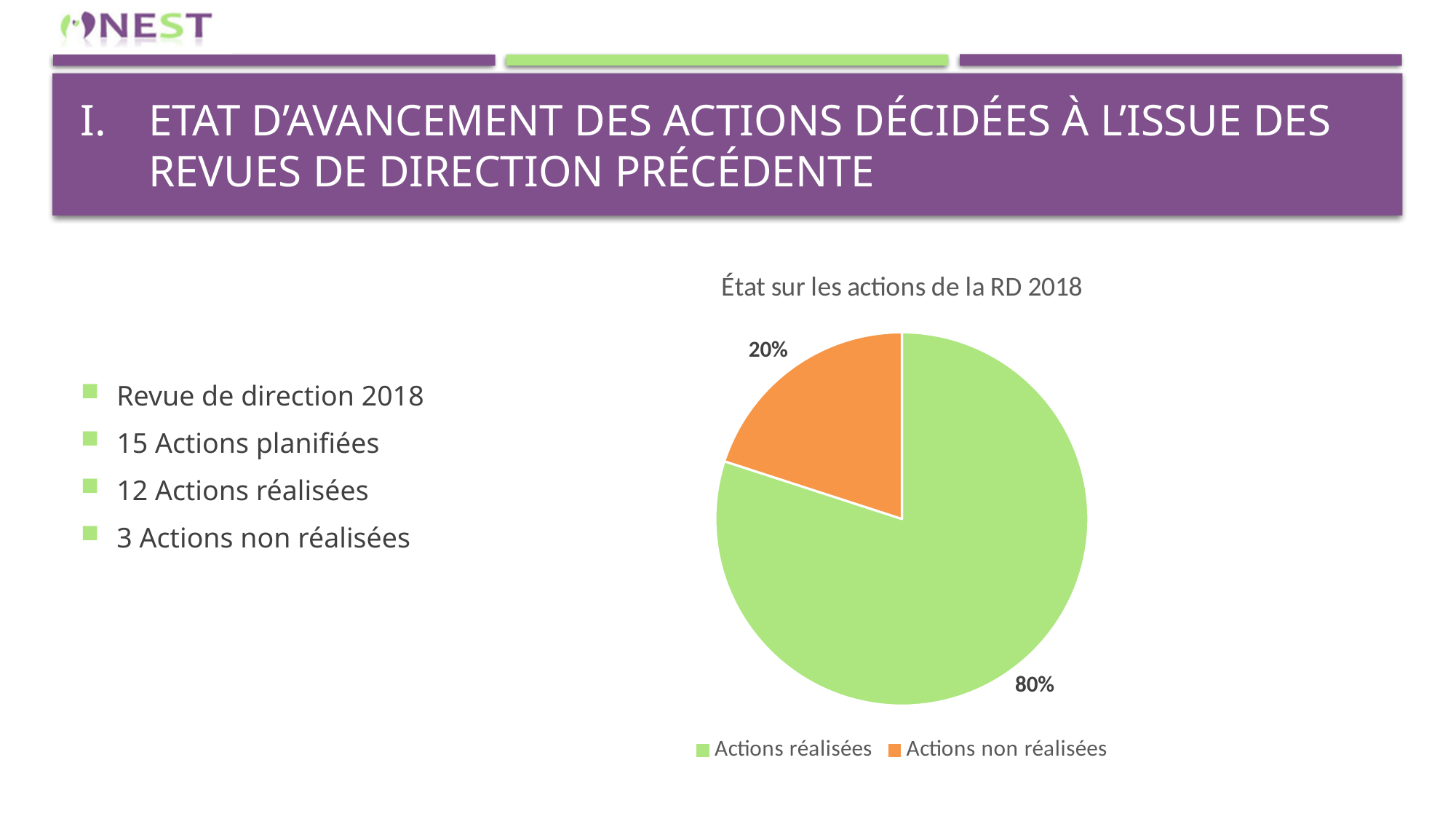
What colour is the 'Actions non réalisées' slice? orange What type of chart is shown on the slide? pie chart How many slices does the pie chart have? 2 What is the difference in percentage points between 'Actions réalisées' and 'Actions non réalisées'? 60 percentage points What share of the pie is 'Actions non réalisées'? 20% Which slice is the largest? Actions réalisées How many entries does the legend list? 2 What share of the pie is 'Actions réalisées'? 80% Which is larger, 'Actions réalisées' or 'Actions non réalisées'? Actions réalisées What is the title of the chart? État sur les actions de la RD 2018 Which slice is the smallest? Actions non réalisées